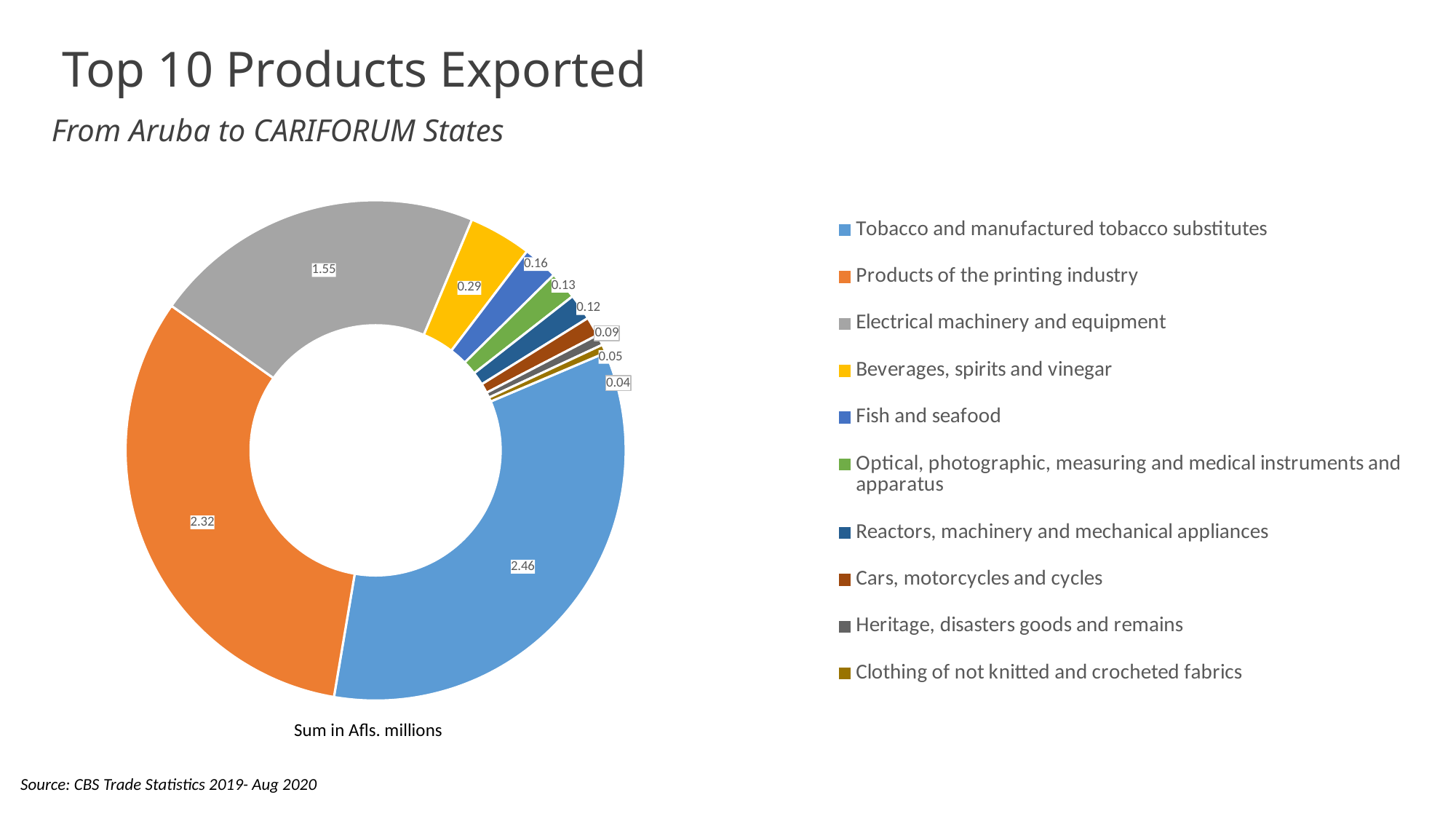
What unit is the chart's data given in, according to the label below the chart? Sum in Afls. millions How many product categories are shown in the chart? 10 What kind of chart is shown on the slide? Doughnut (pie) chart Which product category has the highest export value? Tobacco and manufactured tobacco substitutes What is the difference between the values for Tobacco and manufactured tobacco substitutes and Products of the printing industry? 0.14 What is the total of all the values shown in the chart? 7.21 What is the value for Fish and seafood? 0.16 Which is larger, the value for Electrical machinery and equipment or the value for Beverages, spirits and vinegar? Electrical machinery and equipment What is the value for Beverages, spirits and vinegar? 0.29 What is the value for Electrical machinery and equipment? 1.55 What is the value for Tobacco and manufactured tobacco substitutes? 2.46 Which product category has the lowest export value? Clothing of not knitted and crocheted fabrics